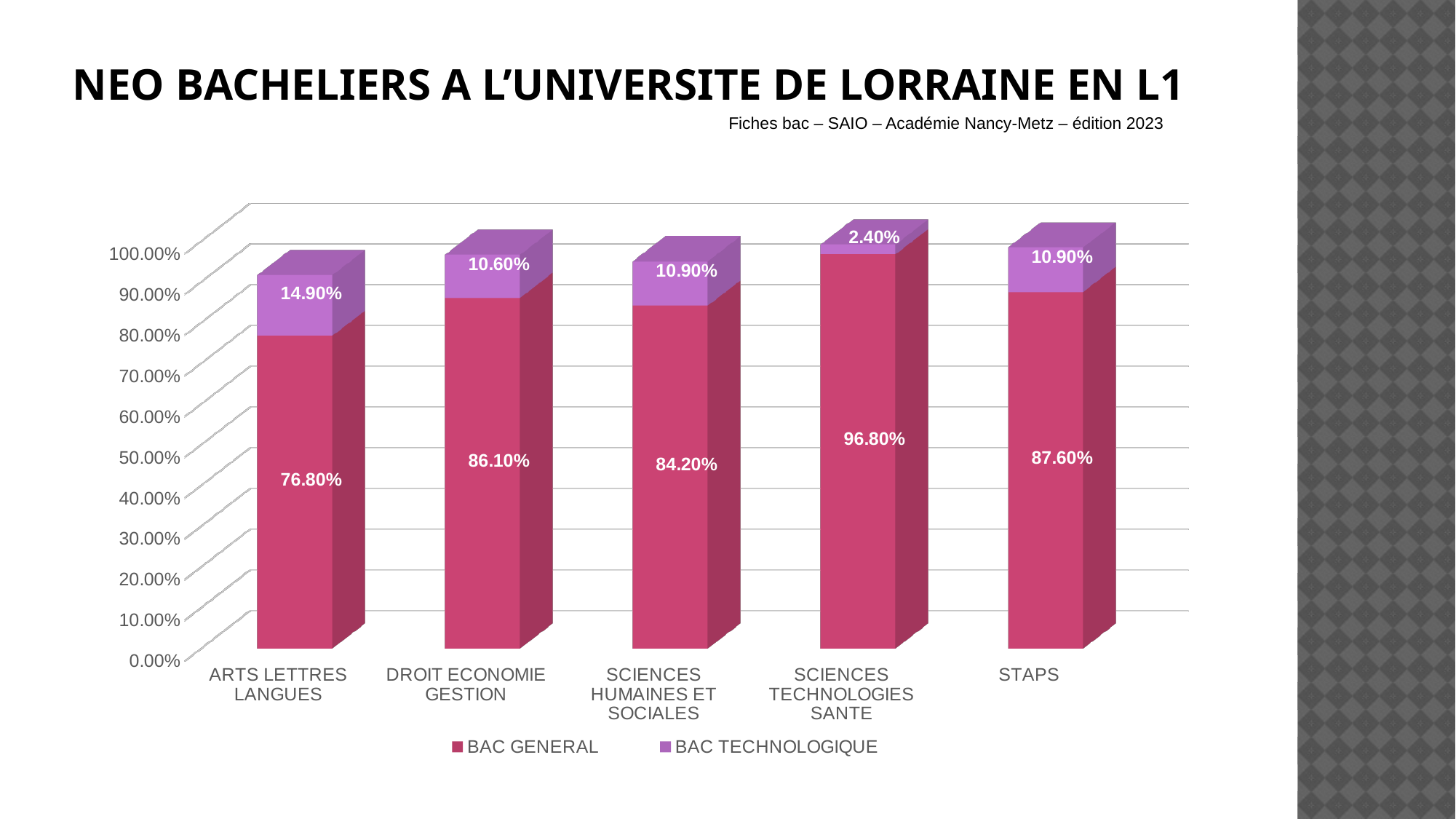
Which category has the lowest BAC TECHNOLOGIQUE value? SCIENCES TECHNOLOGIES SANTE How many categories are shown on the x axis? 5 What is the BAC GENERAL value for STAPS? 87.60% How many series does the legend list? 2 Which category has the lowest BAC GENERAL value? ARTS LETTRES LANGUES What is the BAC GENERAL value for SCIENCES HUMAINES ET SOCIALES? 84.20% Which category has the highest BAC GENERAL value? SCIENCES TECHNOLOGIES SANTE Which is larger, the BAC GENERAL value for DROIT ECONOMIE GESTION or for SCIENCES HUMAINES ET SOCIALES? DROIT ECONOMIE GESTION What kind of chart is shown on the slide? Stacked bar chart What is the difference between the BAC GENERAL values for STAPS and ARTS LETTRES LANGUES? 10.80% What is the total of the stacked bar for SCIENCES TECHNOLOGIES SANTE? 99.20% What is the BAC TECHNOLOGIQUE value for ARTS LETTRES LANGUES? 14.90%